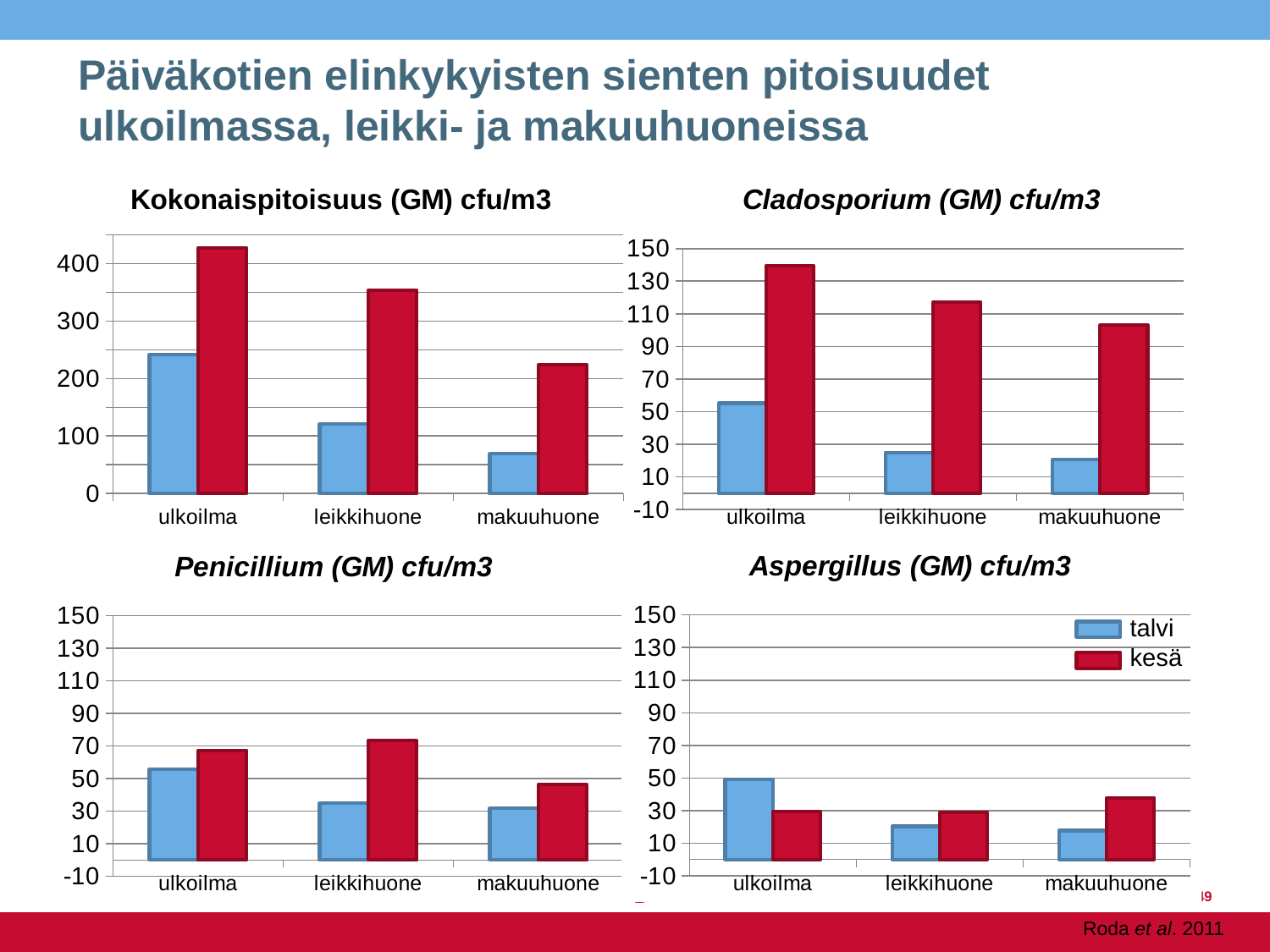
In the Aspergillus (GM) cfu/m3 chart, is the talvi value for makuuhuone greater or less than 30? less In the Penicillium (GM) cfu/m3 chart, which is larger for leikkihuone, talvi or kesä? kesä In the Kokonaispitoisuus (GM) cfu/m3 chart, which category has the highest kesä value? ulkoilma In the Aspergillus (GM) cfu/m3 chart, how many series does the legend list? 2 In the Aspergillus (GM) cfu/m3 chart, which is larger for ulkoilma, talvi or kesä? talvi According to the legend on the Aspergillus (GM) cfu/m3 chart, what colour represents the kesä series? red In the Kokonaispitoisuus (GM) cfu/m3 chart, is the kesä value for ulkoilma greater or less than 400? greater In the Kokonaispitoisuus (GM) cfu/m3 chart, do the talvi values rise or fall from ulkoilma to makuuhuone? fall How many categories are shown on the x axis of the Cladosporium (GM) cfu/m3 chart? 3 In the Cladosporium (GM) cfu/m3 chart, which category has the lowest kesä value? makuuhuone What kind of chart is the Kokonaispitoisuus (GM) cfu/m3 chart? bar chart In the Cladosporium (GM) cfu/m3 chart, is the kesä value for ulkoilma greater or less than 130? greater